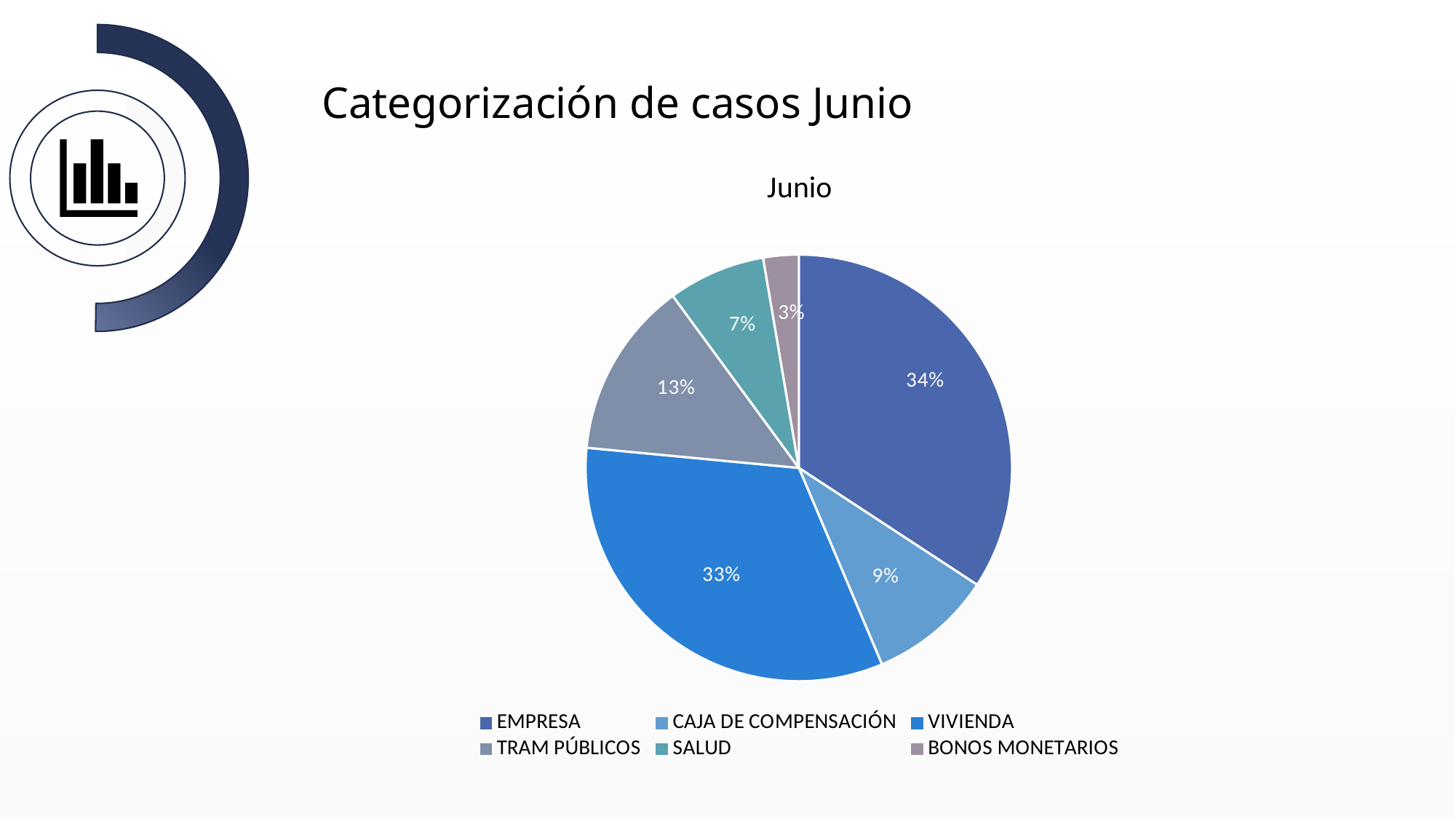
What is the value shown for CAJA DE COMPENSACIÓN? 9% Which is larger, the share for CAJA DE COMPENSACIÓN or the share for SALUD? CAJA DE COMPENSACIÓN What is the title of the chart? Junio What share of the pie does VIVIENDA represent? 33% Which category has the largest slice of the pie? EMPRESA What is the value shown for TRAM PÚBLICOS? 13% What share of the pie does EMPRESA represent? 34% What is the difference between the shares of TRAM PÚBLICOS and SALUD? 6% Which category has the smallest slice of the pie? BONOS MONETARIOS What kind of chart is shown on the slide? Pie chart What is the value shown for SALUD? 7% How many categories are shown in the pie chart? 6